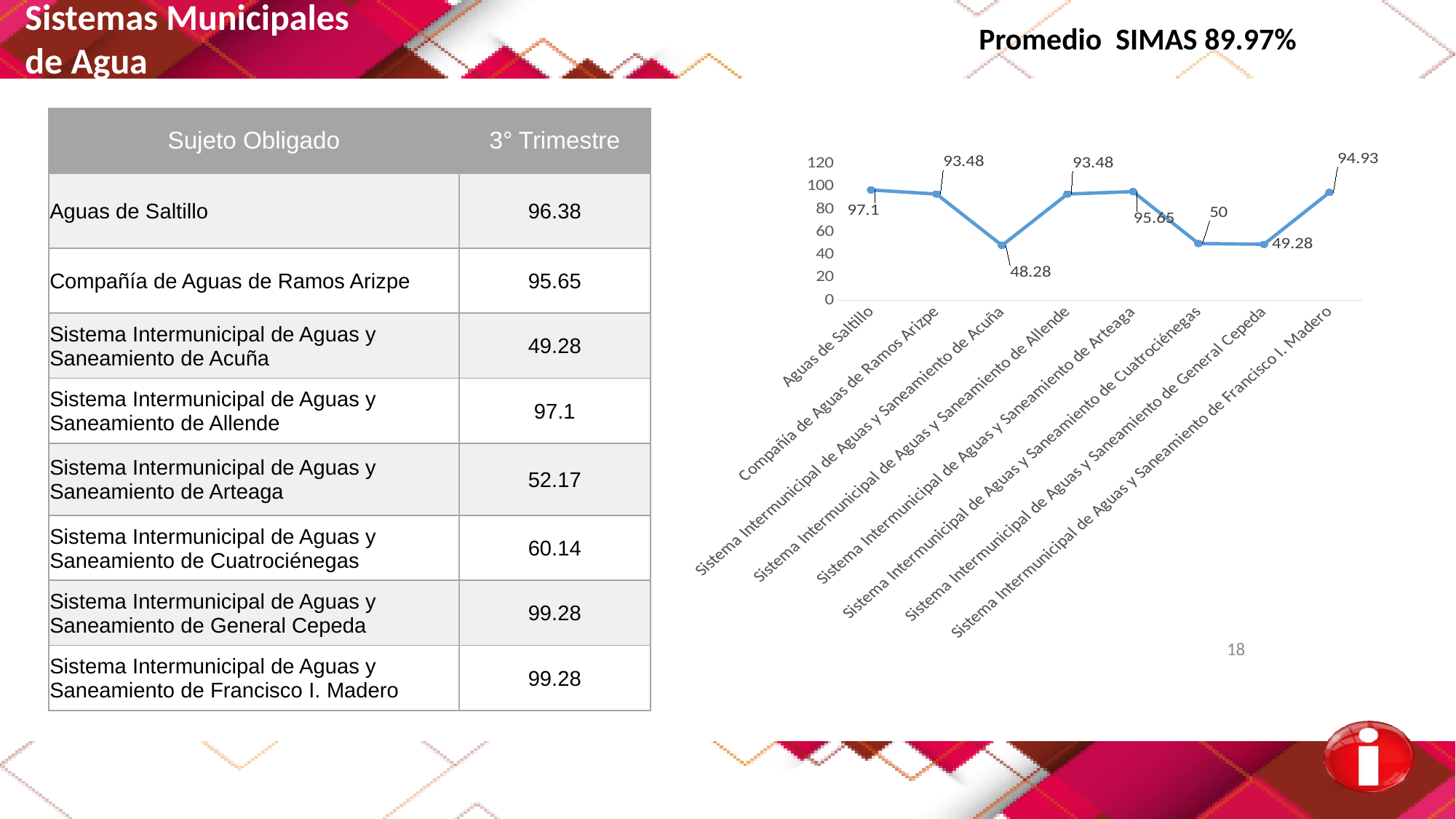
Which category has the lowest value on the chart? Sistema Intermunicipal de Aguas y Saneamiento de Acuña What kind of chart is shown on the slide? line chart What is the difference between the chart values for Aguas de Saltillo and Sistema Intermunicipal de Aguas y Saneamiento de Acuña? 48.82 What value does the chart show for Aguas de Saltillo? 97.1 What value does the chart show for Sistema Intermunicipal de Aguas y Saneamiento de Acuña? 48.28 Which category has the highest value on the chart? Aguas de Saltillo How many categories are plotted on the chart? 8 What is the highest value shown on the chart's vertical axis? 120 What value does the chart show for Sistema Intermunicipal de Aguas y Saneamiento de Francisco I. Madero? 94.93 On the chart, which is larger: the value for Sistema Intermunicipal de Aguas y Saneamiento de Arteaga or for Sistema Intermunicipal de Aguas y Saneamiento de Allende? Sistema Intermunicipal de Aguas y Saneamiento de Arteaga What value does the chart show for Sistema Intermunicipal de Aguas y Saneamiento de Cuatrociénegas? 50 Is the chart value for Sistema Intermunicipal de Aguas y Saneamiento de General Cepeda greater or less than 60? less